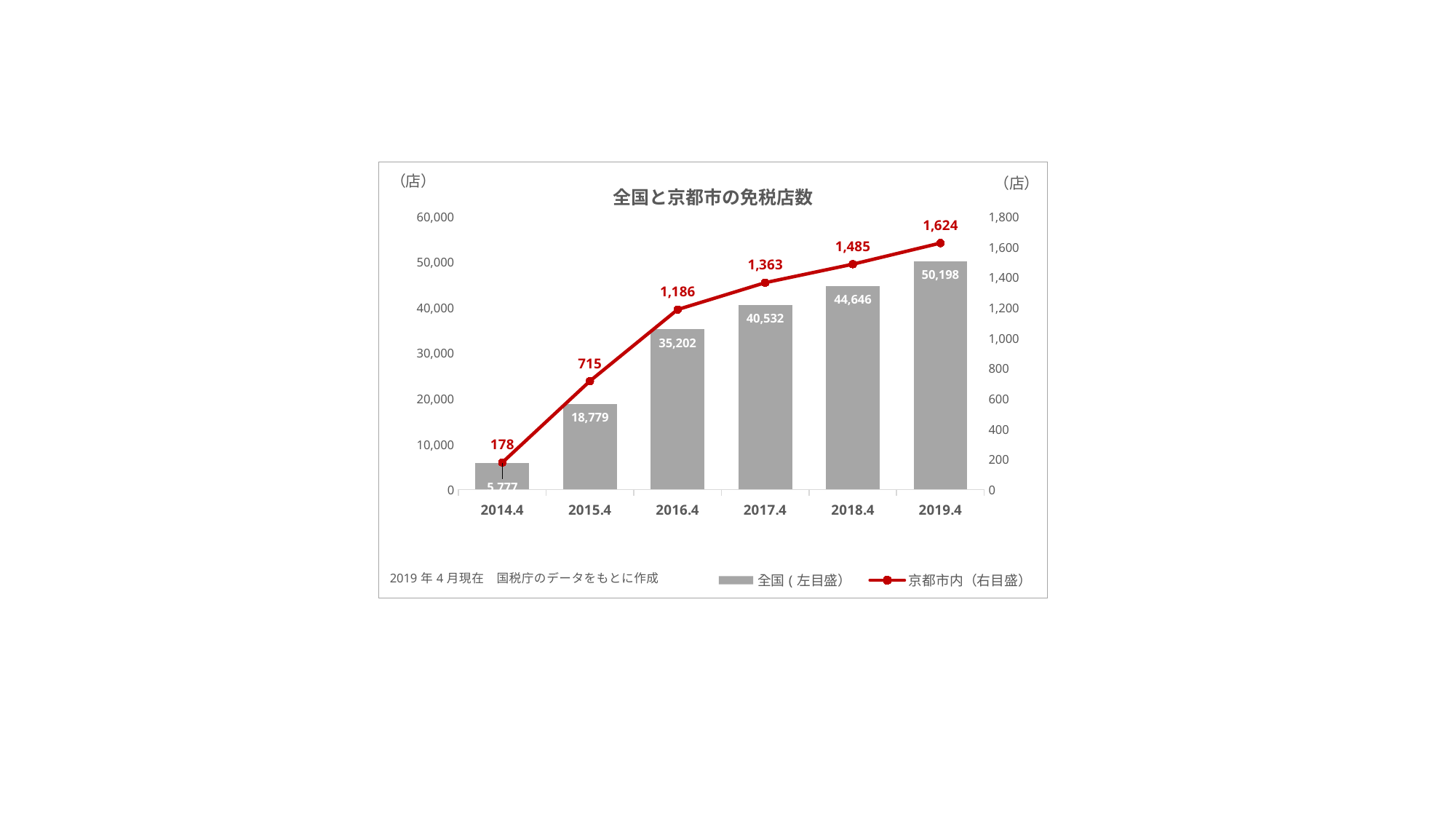
What is the difference between the 全国 values for 2018.4 and 2017.4? 4,114 How many series does the legend list? 2 What is the value for 京都市内 in 2014.4? 178 Do the 京都市内 values rise or fall from 2014.4 to 2019.4? rise In which year is the 京都市内 value lowest? 2014.4 How many years are shown on the x axis? 6 What is the value for 全国 in 2015.4? 18,779 What is the value for 全国 in 2019.4? 50,198 What is the difference between the 京都市内 values for 2019.4 and 2018.4? 139 In which year is the 全国 value highest? 2019.4 What is the value for 京都市内 in 2016.4? 1,186 Which is larger, the 全国 value for 2016.4 or for 2015.4? 2016.4